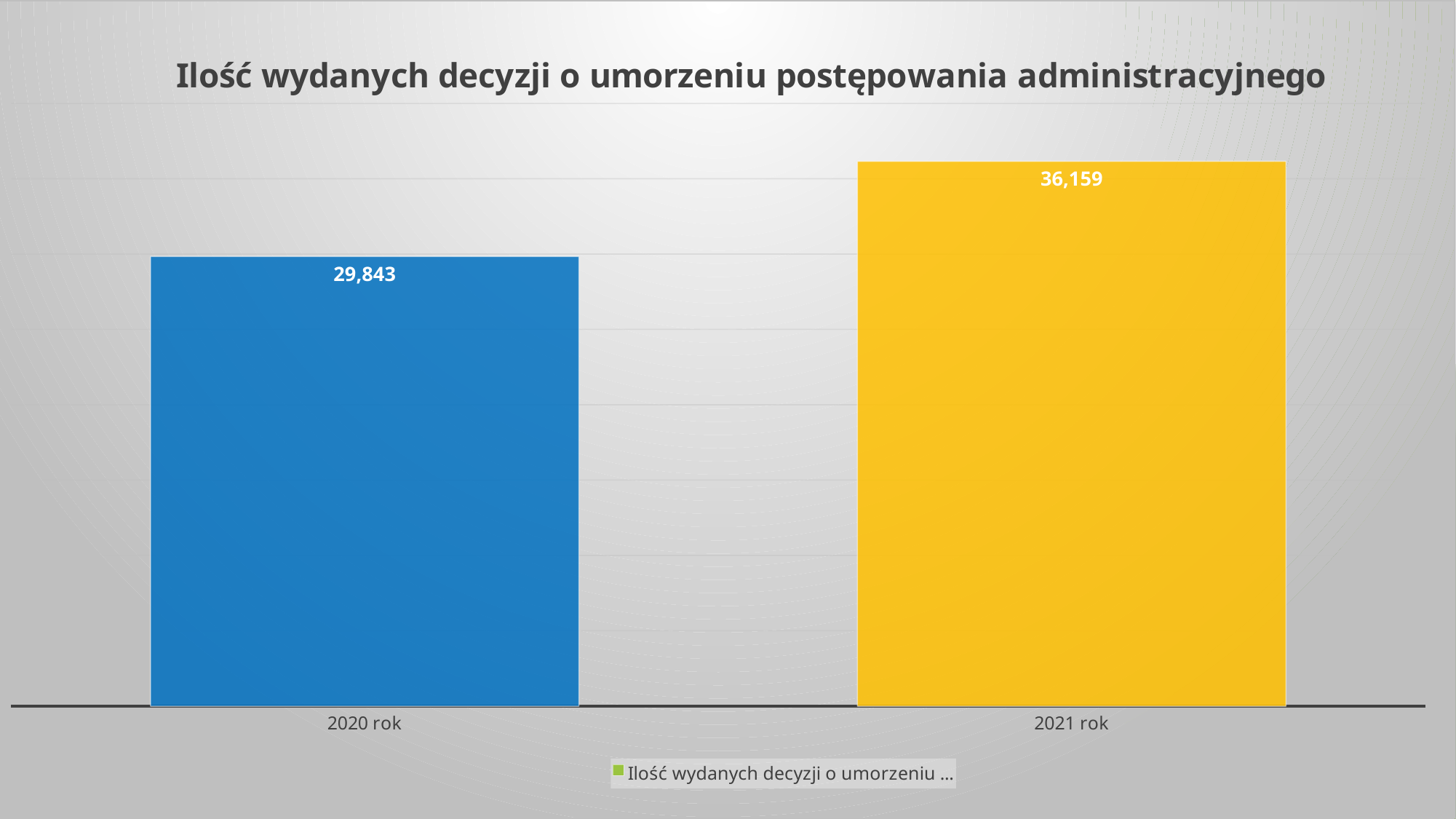
What kind of chart is shown on the slide? bar chart What is the value for 2021 rok? 36,159 Which category has the lowest value? 2020 rok How many categories are shown on the x axis? 2 Which is larger, the value for 2020 rok or the value for 2021 rok? 2021 rok What colour is the bar for 2021 rok? yellow How many series does the legend list? 1 What is the value for 2020 rok? 29,843 What is the title of the chart? Ilość wydanych decyzji o umorzeniu postępowania administracyjnego Which category has the highest value? 2021 rok Do the values rise or fall from 2020 rok to 2021 rok? rise What is the difference between the values for 2021 rok and 2020 rok? 6,316